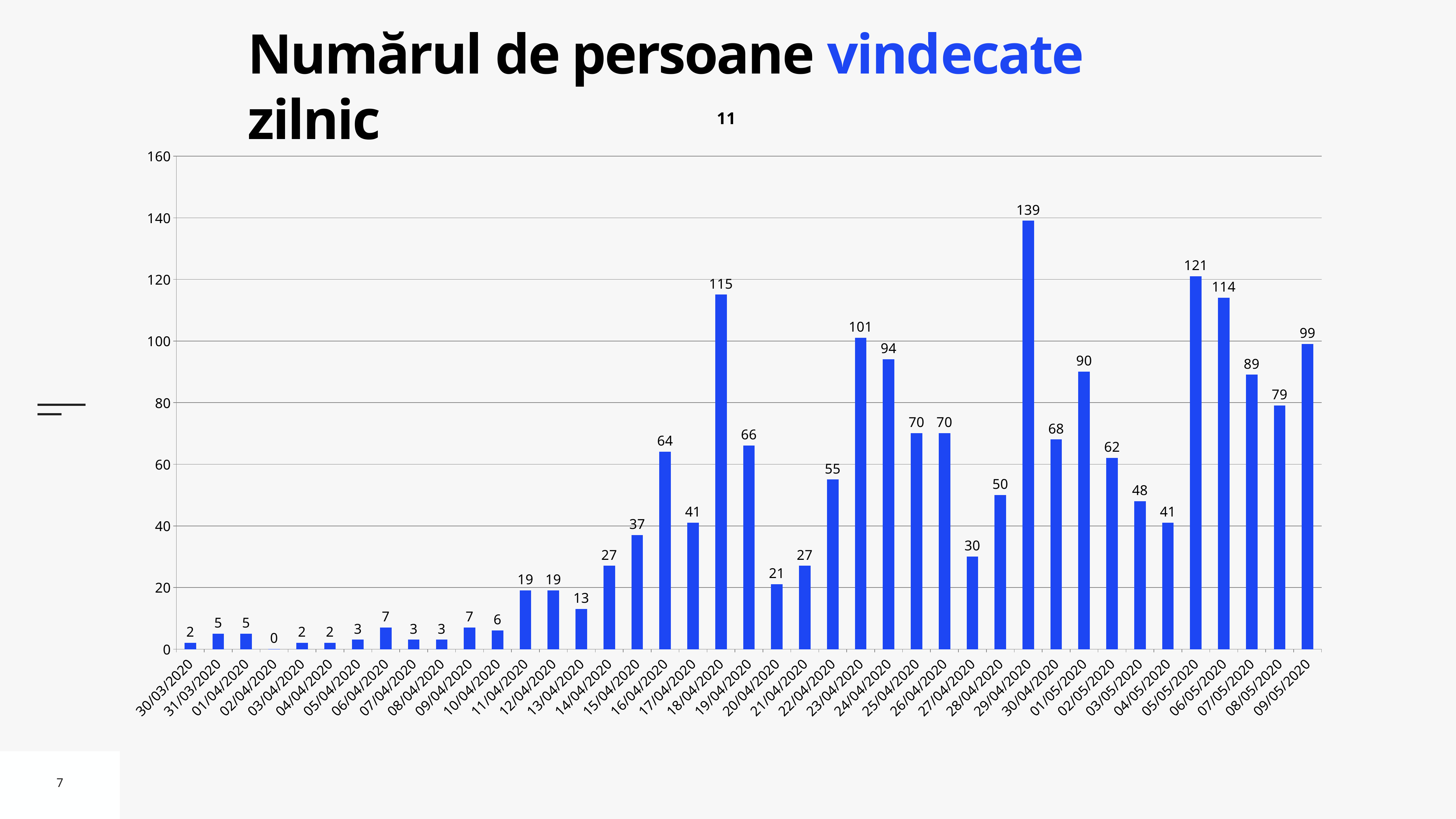
Which date has the highest value? 29/04/2020 What is the title of the slide? Numărul de persoane vindecate zilnic What kind of chart is shown on the slide? bar chart What is the value for 29/04/2020? 139 What is the difference between the values for 05/05/2020 and 06/05/2020? 7 Is the value for 01/05/2020 greater or less than 80? greater Which date has the lowest value? 02/04/2020 What is the value for 09/05/2020? 99 Which is larger, the value for 23/04/2020 or the value for 24/04/2020? 23/04/2020 What is the difference between the values for 29/04/2020 and 30/04/2020? 71 How many dates are shown on the x axis? 41 What is the value for 18/04/2020? 115